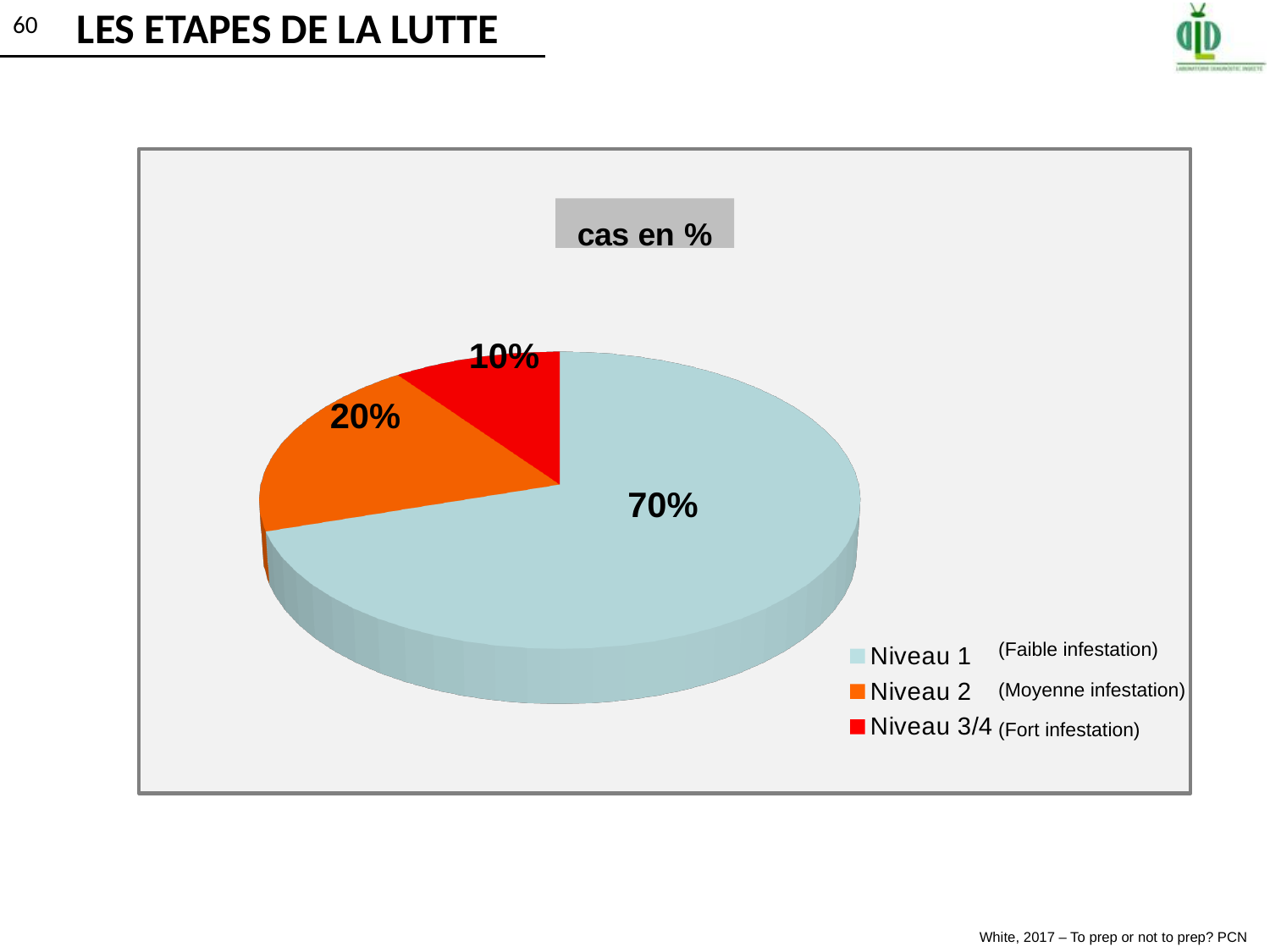
Which colour represents Niveau 3/4 in the pie chart? red What percentage of cases is Niveau 3/4? 10% What is the difference in percentage points between Niveau 1 and Niveau 2? 50 What is the chart's title? cas en % How many entries does the legend list? 3 Which category has the largest share of the pie? Niveau 1 What percentage of cases is Niveau 2? 20% What type of chart is shown on the slide? pie chart What percentage of cases is Niveau 1? 70% How many slices does the pie chart have? 3 Which category has the smallest share of the pie? Niveau 3/4 Which is larger, the share for Niveau 2 or the share for Niveau 3/4? Niveau 2